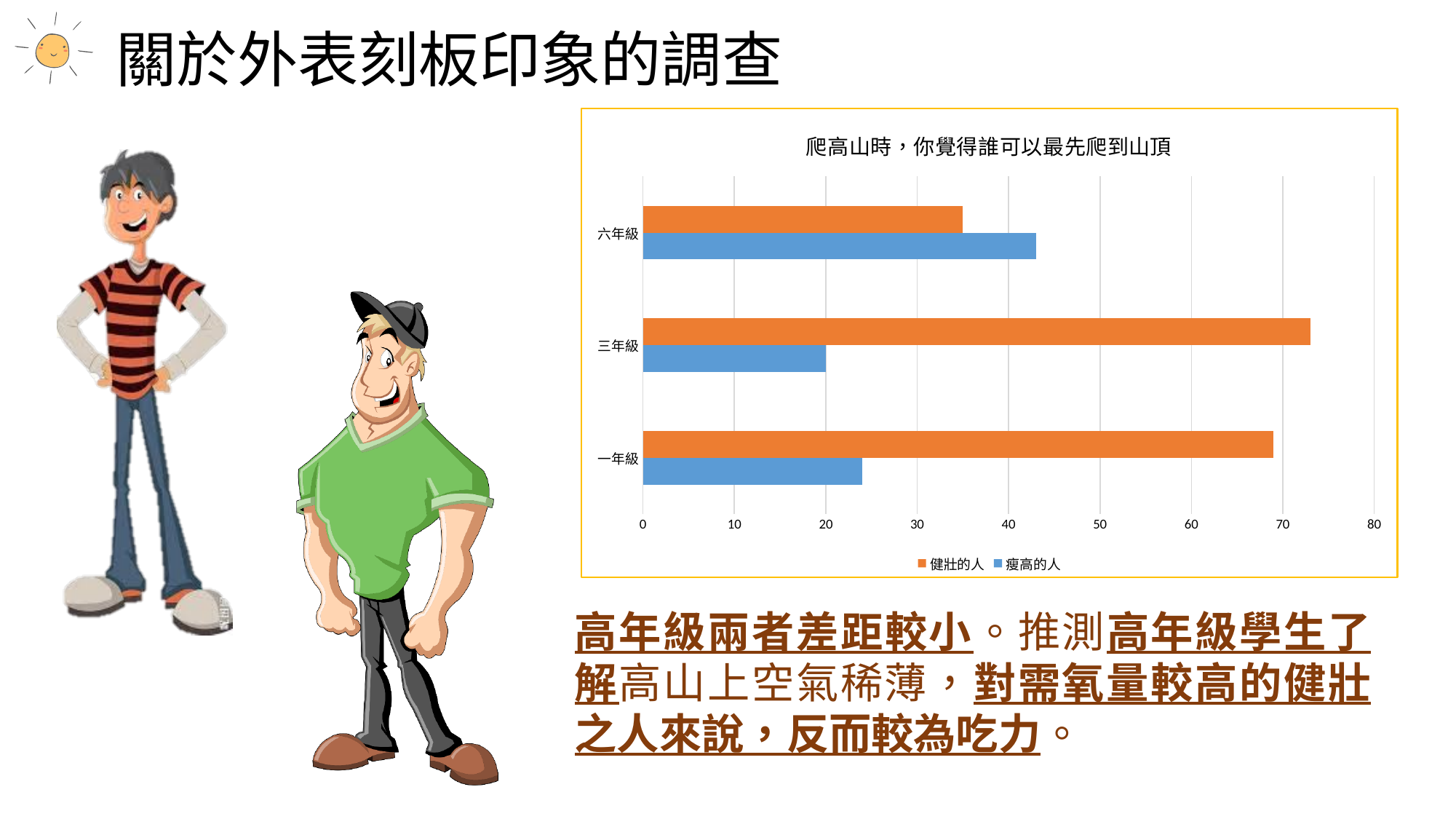
Which grade has the lowest value for 瘦高的人? 三年級 Which colour represents 健壯的人 in the chart? orange Is the value for 瘦高的人 in 六年級 greater or less than 40? greater Which grade has the highest value for 健壯的人? 三年級 What kind of chart is shown on the slide? bar chart How many grade categories are shown on the chart? 3 Is the value for 健壯的人 in 一年級 greater or less than 60? greater What is the title of the chart? 爬高山時，你覺得誰可以最先爬到山頂 For 六年級, which is larger: 健壯的人 or 瘦高的人? 瘦高的人 How many series does the chart legend list? 2 Is the value for 瘦高的人 in 一年級 greater or less than 30? less For 三年級, which is larger: 健壯的人 or 瘦高的人? 健壯的人